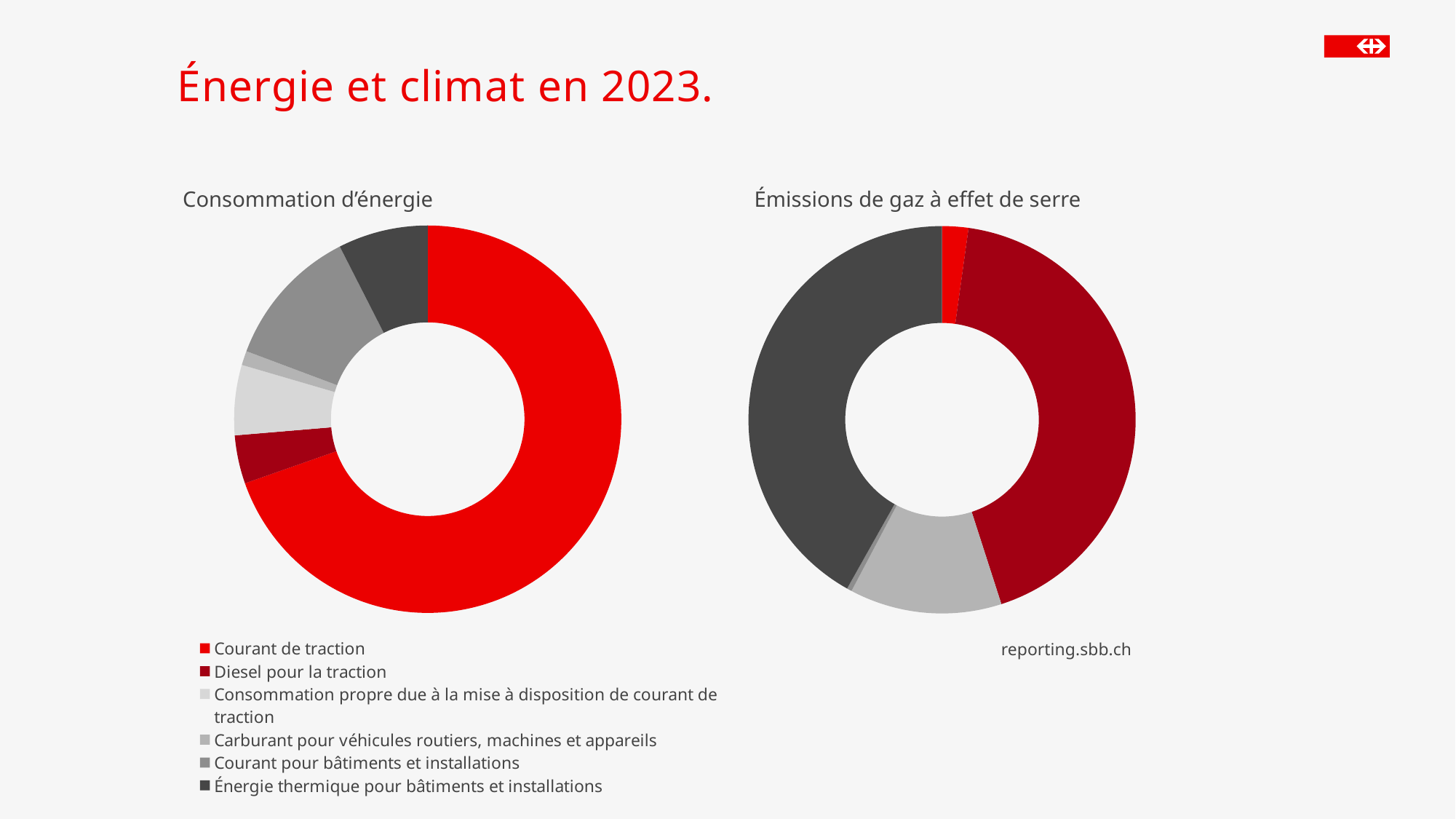
In the 'Consommation d'énergie' chart, which category has the smallest slice? Carburant pour véhicules routiers, machines et appareils In the 'Émissions de gaz à effet de serre' chart, which is larger: Courant pour bâtiments et installations or Courant de traction? Courant de traction What is the title of the chart on the right? Émissions de gaz à effet de serre How many categories does the legend list? 6 In the 'Consommation d'énergie' chart, which category has the largest slice? Courant de traction In the 'Émissions de gaz à effet de serre' chart, which is larger: Diesel pour la traction or Courant de traction? Diesel pour la traction What kind of chart is the 'Consommation d'énergie' chart? Pie chart (donut) Which colour represents Courant de traction in the legend? Red In the 'Consommation d'énergie' chart, which is larger: Courant de traction or Diesel pour la traction? Courant de traction What kind of chart is the 'Émissions de gaz à effet de serre' chart? Pie chart (donut)